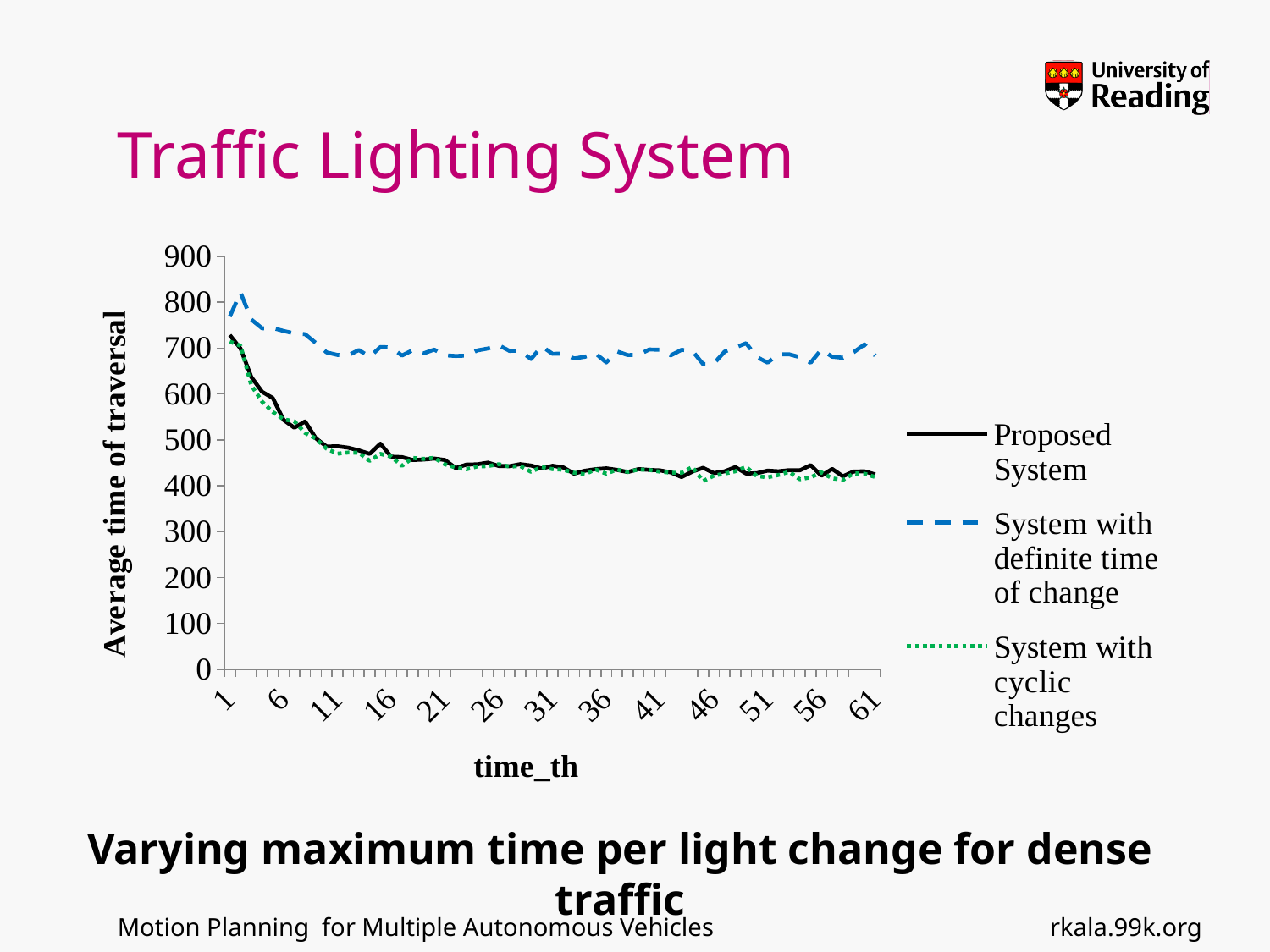
What is the highest value shown on the vertical axis? 900 How many series does the legend list? 3 What kind of chart is shown on the slide? line chart Is the value for Proposed System at time_th 11 greater or less than 600? less Does the Proposed System line rise or fall as time_th increases? fall What is the title of the vertical axis? Average time of traversal Is the value for Proposed System at time_th 61 greater or less than 500? less At time_th 31, which is larger: Proposed System or System with definite time of change? System with definite time of change What is the title of the horizontal axis? time_th Is the value for System with definite time of change at time_th 61 greater or less than 600? greater Which series has the highest values across the chart? System with definite time of change